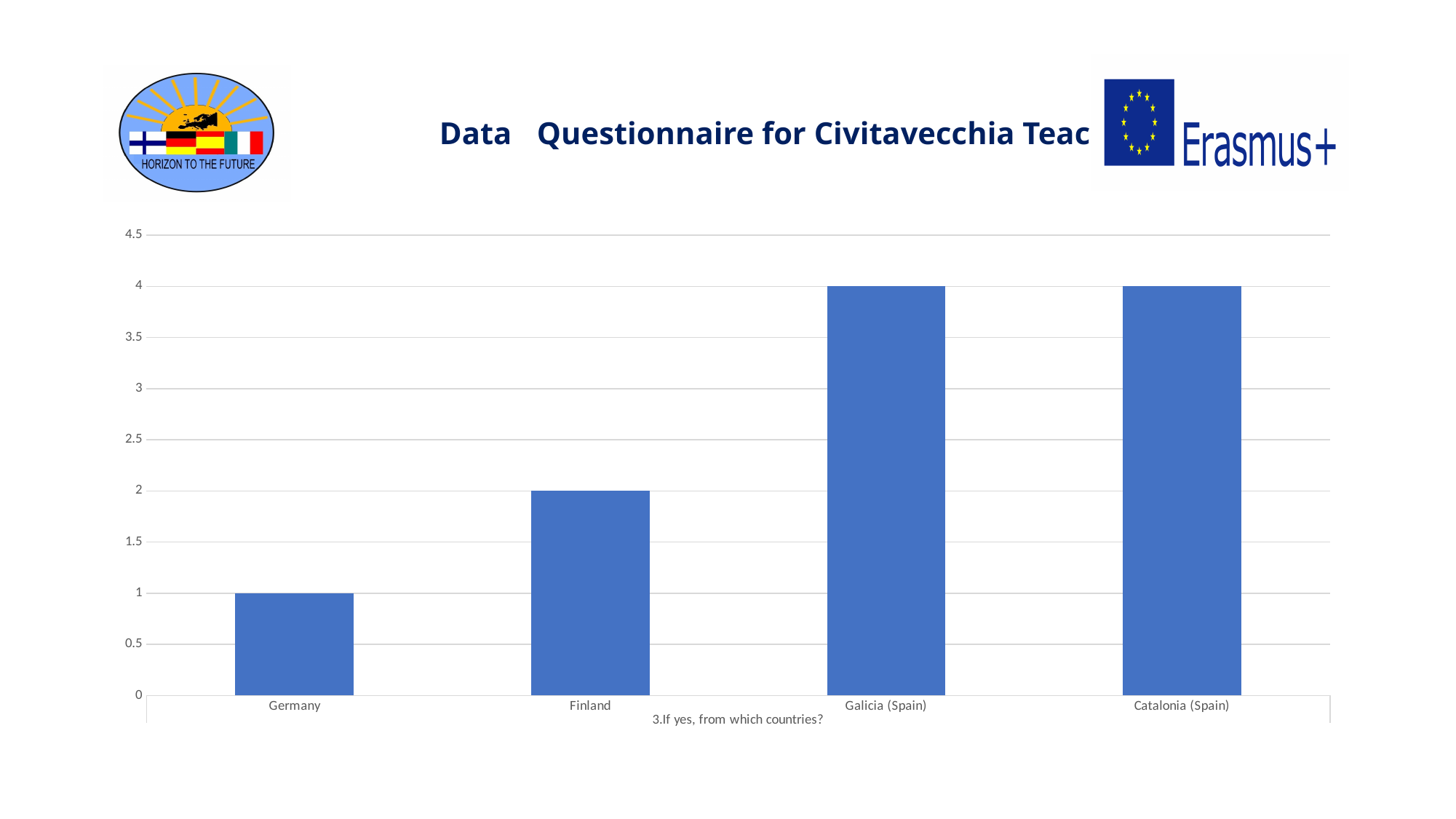
What is the difference between the values for Galicia (Spain) and Germany? 3 What is the axis title shown below the category labels? 3.If yes, from which countries? What is the value for Germany? 1 What is the value for Finland? 2 Is the value for Galicia (Spain) greater or less than 3? greater How many categories are shown on the x axis? 4 What is the difference between the values for Finland and Germany? 1 What is the value for Galicia (Spain)? 4 Which category has the lowest value? Germany Which is larger, the value for Finland or the value for Germany? Finland What is the value for Catalonia (Spain)? 4 What kind of chart is shown on the slide? bar chart